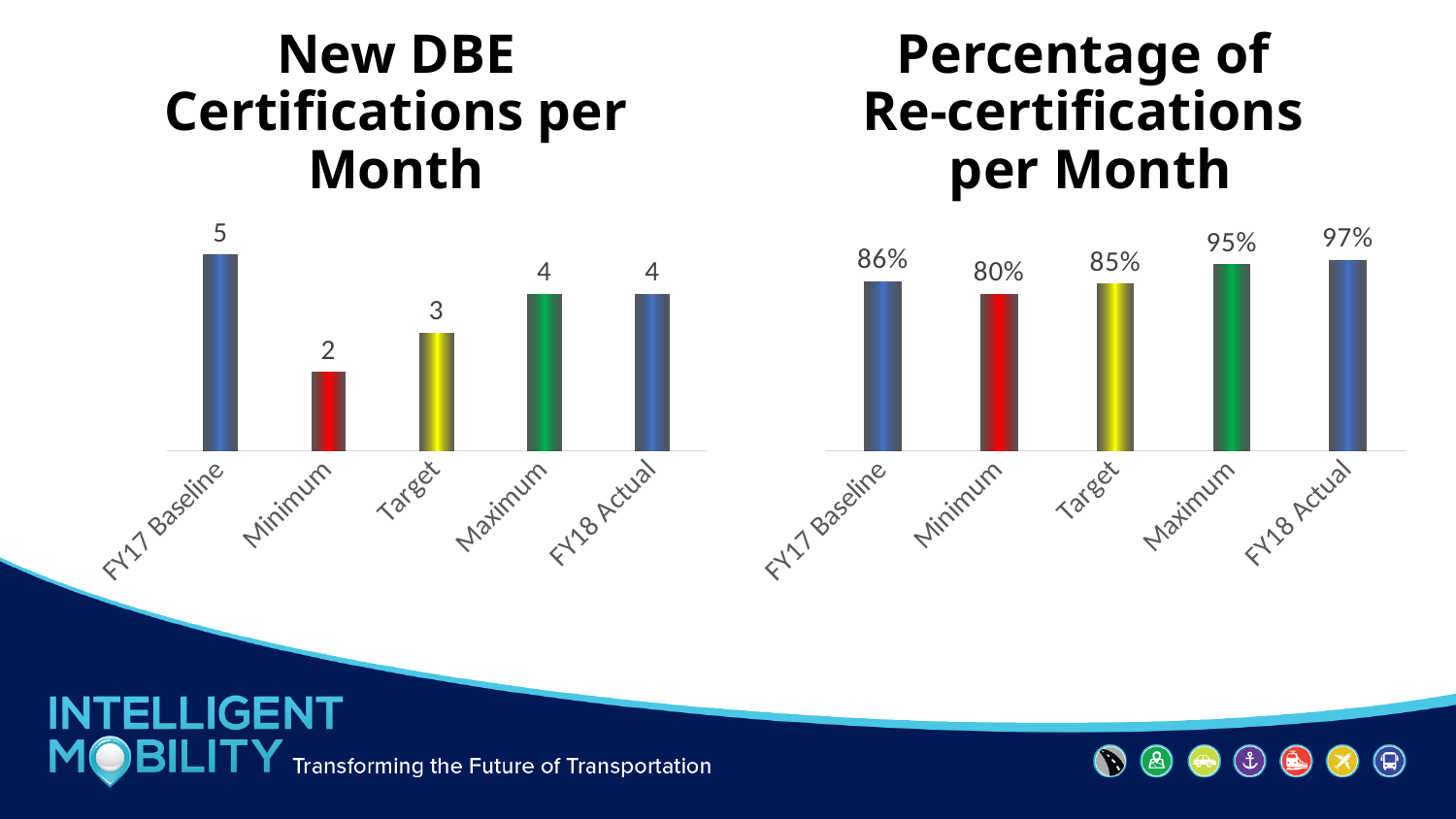
In the 'Percentage of Re-certifications per Month' chart, what is the difference between the FY18 Actual and Target values? 12% In the 'New DBE Certifications per Month' chart, which category has the lowest value? Minimum In the 'New DBE Certifications per Month' chart, what is the value for FY17 Baseline? 5 In the 'New DBE Certifications per Month' chart, how many categories are shown? 5 In the 'New DBE Certifications per Month' chart, what is the value for Target? 3 In the 'Percentage of Re-certifications per Month' chart, what is the value for Minimum? 80% What kind of chart is the 'Percentage of Re-certifications per Month' chart? Bar chart In the 'New DBE Certifications per Month' chart, which category has the highest value? FY17 Baseline In the 'Percentage of Re-certifications per Month' chart, which is larger, the FY17 Baseline value or the Target value? FY17 Baseline In the 'New DBE Certifications per Month' chart, what is the difference between the FY17 Baseline and Minimum values? 3 In the 'Percentage of Re-certifications per Month' chart, which category has the highest value? FY18 Actual In the 'Percentage of Re-certifications per Month' chart, what is the value for FY18 Actual? 97%